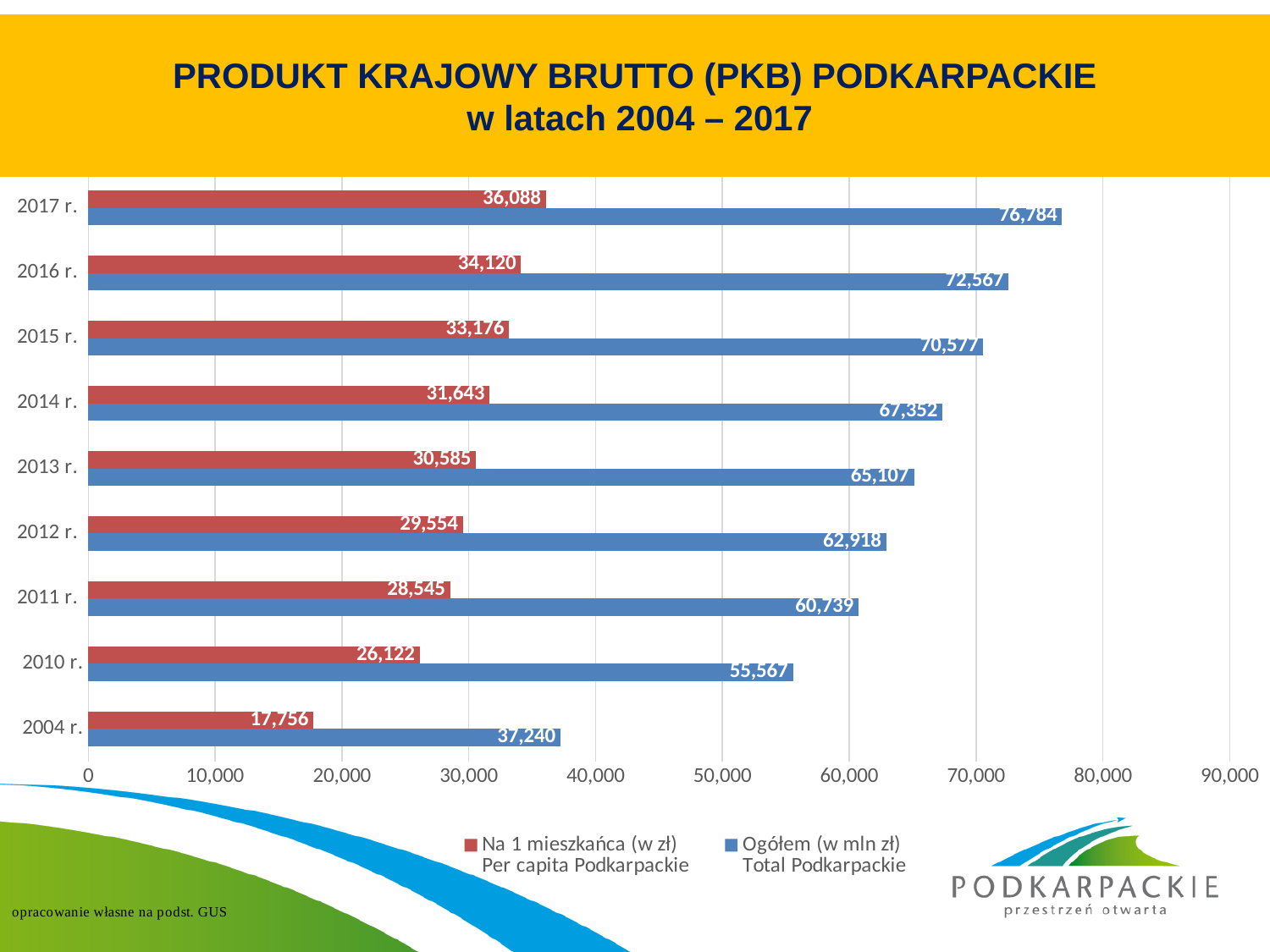
What is the value of Ogółem (w mln zł) Total Podkarpackie for 2010 r.? 55,567 What is the difference between the Ogółem (w mln zł) Total Podkarpackie values for 2017 r. and 2016 r.? 4,217 Which is larger: the Na 1 mieszkańca (w zł) Per capita Podkarpackie value for 2012 r. or for 2011 r.? 2012 r. Which year has the highest value for Ogółem (w mln zł) Total Podkarpackie? 2017 r. What is the value of Na 1 mieszkańca (w zł) Per capita Podkarpackie for 2004 r.? 17,756 Is the Ogółem (w mln zł) Total Podkarpackie value for 2014 r. greater or less than 70,000? less Which year has the lowest value for Na 1 mieszkańca (w zł) Per capita Podkarpackie? 2004 r. How many years are shown on the chart? 9 What is the value of Ogółem (w mln zł) Total Podkarpackie for 2017 r.? 76,784 What is the value of Na 1 mieszkańca (w zł) Per capita Podkarpackie for 2013 r.? 30,585 What type of chart is shown on the slide? Bar chart How many series does the legend list? 2